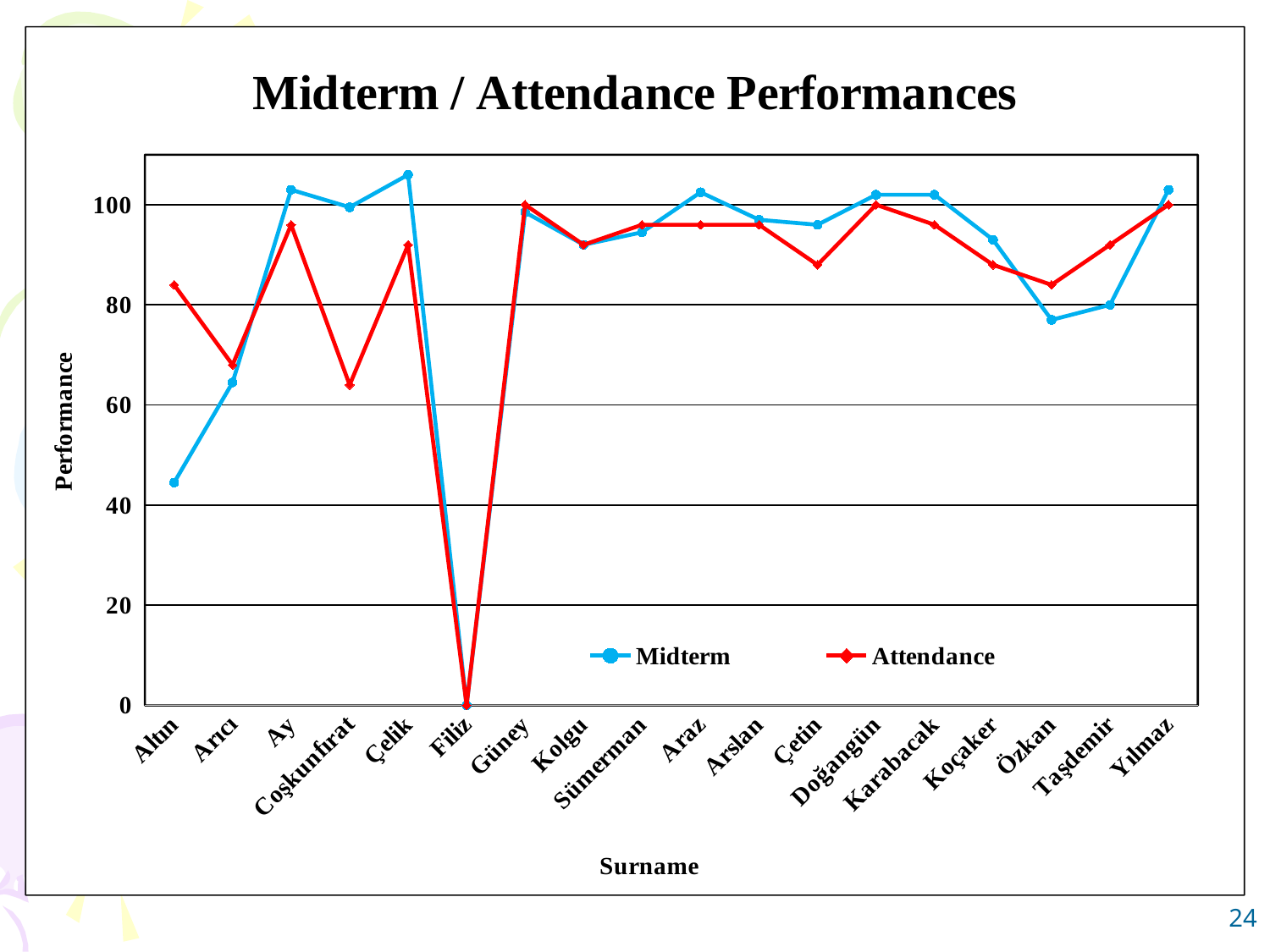
How many series does the legend list? 2 How many surnames are plotted along the x axis? 18 What is the Midterm value for Filiz? 0 Is the Midterm value for Çelik greater or less than 100? greater Is the Attendance value for Coşkunfırat greater or less than 80? less What kind of chart is shown on the slide? line chart What is the title of the chart? Midterm / Attendance Performances Which surname has the lowest Midterm value? Filiz For Coşkunfırat, which is larger: the Midterm value or the Attendance value? Midterm Is the Midterm value for Altın greater or less than 60? less For Altın, which is larger: the Midterm value or the Attendance value? Attendance Which surname has the highest Midterm value? Çelik